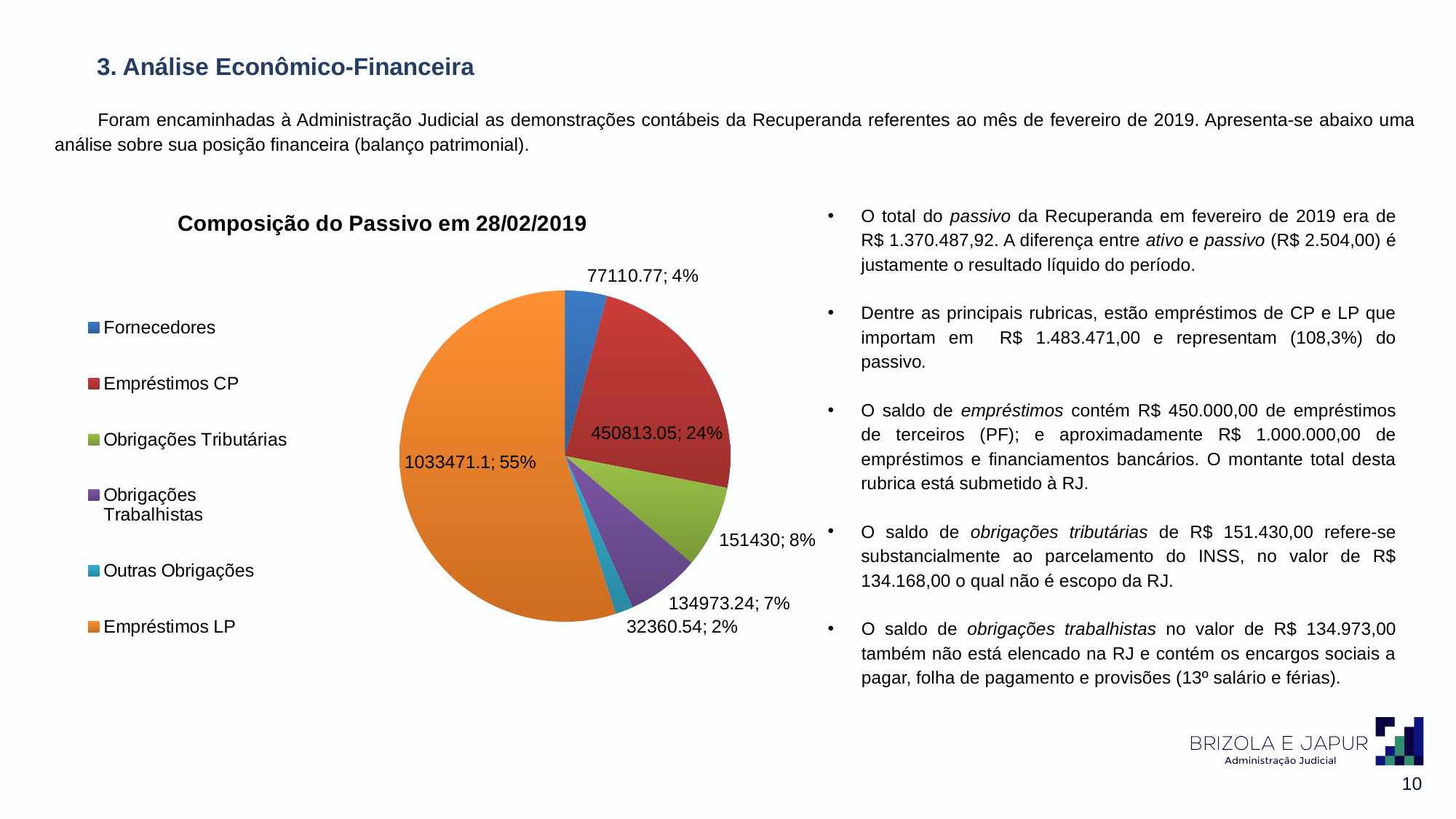
What type of chart is shown on the slide? pie chart What share of the pie does Outras Obrigações represent? 2% What is the title of the chart? Composição do Passivo em 28/02/2019 What share of the pie does Obrigações Trabalhistas represent? 7% What value is shown for Empréstimos LP in the pie chart? 1033471.1 What value is shown for Obrigações Tributárias in the pie chart? 151430 Which category has the smallest slice in the pie chart? Outras Obrigações How many categories does the legend of the pie chart list? 6 Which is larger in the pie chart, Obrigações Tributárias or Obrigações Trabalhistas? Obrigações Tributárias What share of the pie does Fornecedores represent? 4% Which category has the largest slice in the pie chart? Empréstimos LP What value is shown for Empréstimos CP in the pie chart? 450813.05